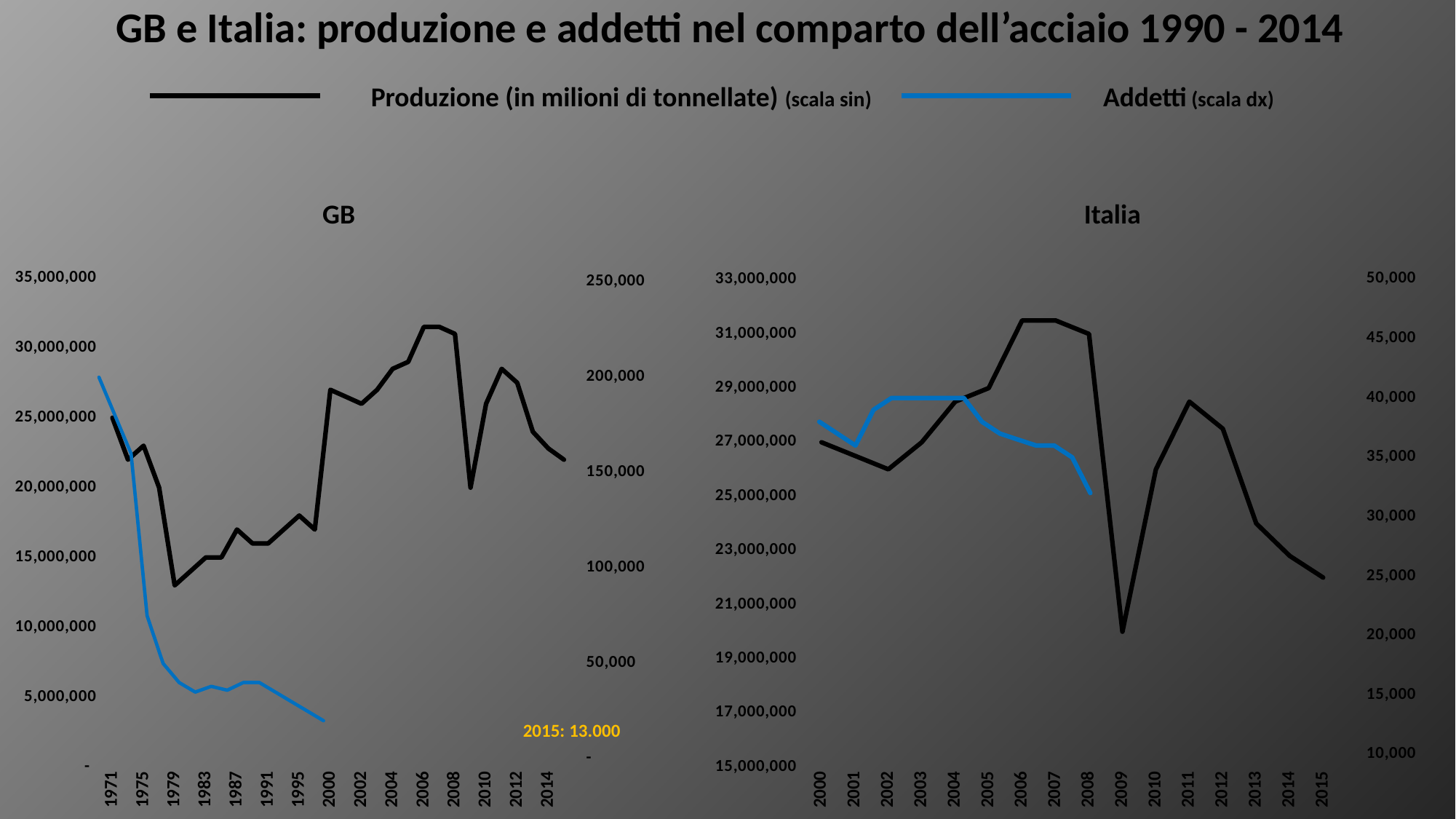
In the Italia chart, is the Addetti value for 2008 greater or less than 35,000? less In the GB chart, is the Addetti value for 1971 greater or less than 150,000? greater Which colour is used for the Addetti series? blue What kind of chart is the GB chart? line chart In the GB chart, is the Produzione value for 2006 greater or less than 30,000,000? greater How many years are labelled on the x axis of the Italia chart? 16 In the GB chart, does the Addetti series rise or fall from 1971 to 2000? fall In the Italia chart, which year has the larger Produzione value, 2011 or 2015? 2011 How many series does the legend list? 2 In the Italia chart, which year has the lowest Produzione value? 2009